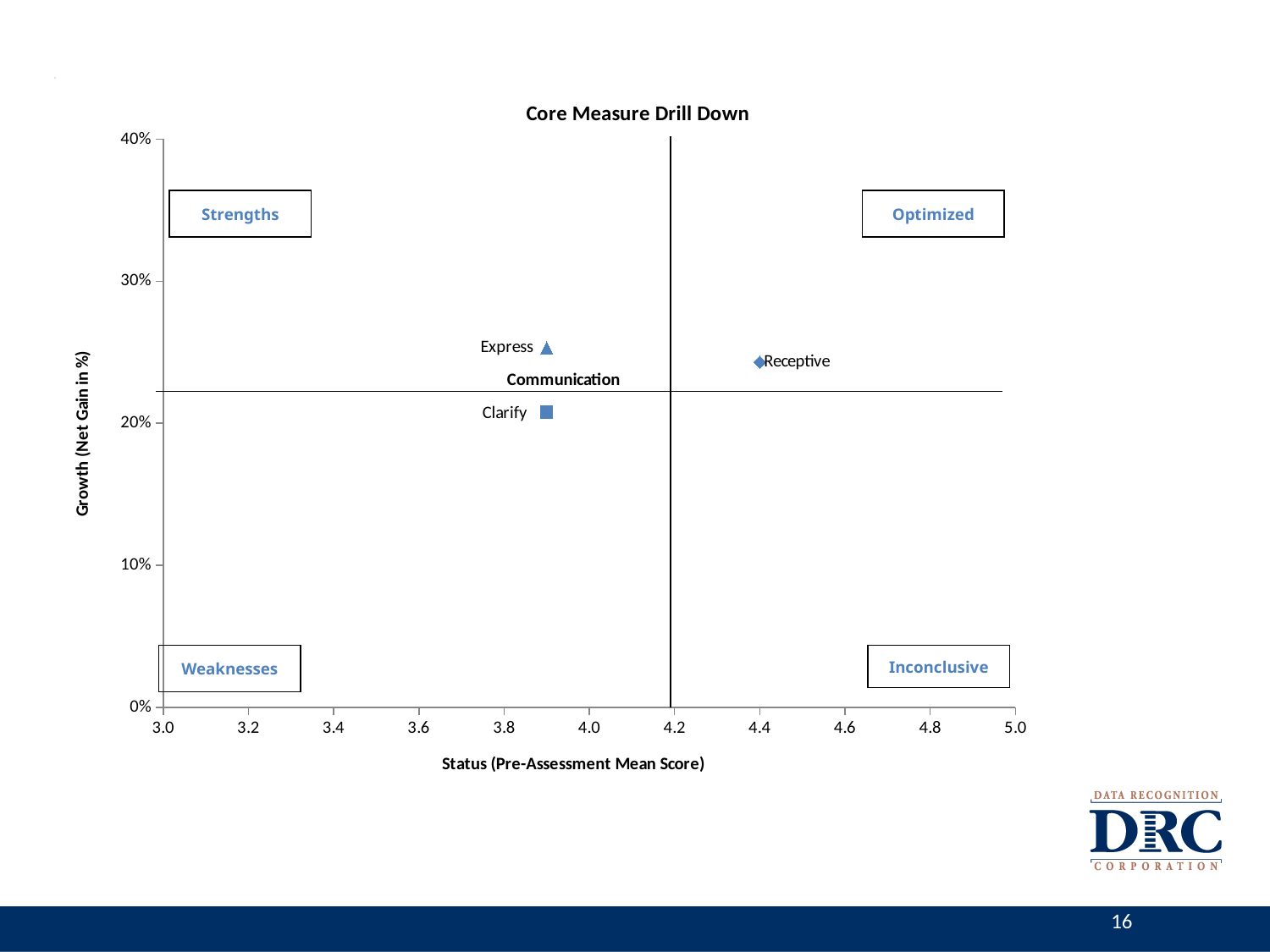
Which has the higher growth value, Express or Clarify? Express Is the growth value for Express greater or less than 20%? greater What is the label of the x axis? Status (Pre-Assessment Mean Score) What kind of chart is shown on the slide? scatter chart What is the title of the chart? Core Measure Drill Down Which has the higher status value, Receptive or Clarify? Receptive Is the status value for Express greater or less than 4.2? less Is the growth value for Clarify greater or less than 30%? less Which point has the highest status (pre-assessment mean score)? Receptive Which point has the lowest growth (net gain in %)? Clarify